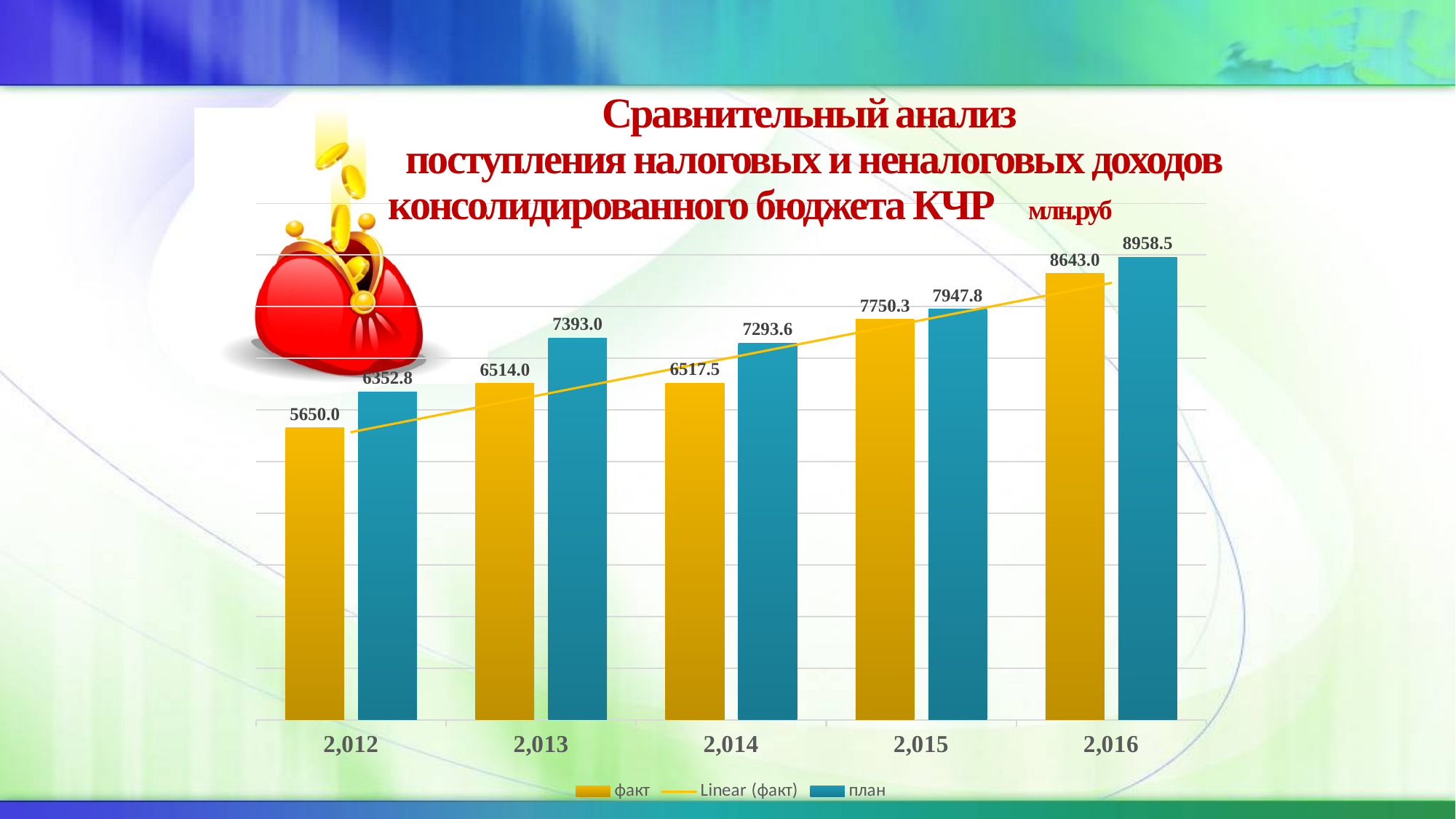
What kind of chart is shown on the slide? bar chart What is the value of план for 2,016? 8958.5 How many years are shown on the x axis? 5 Which year has the lowest план value? 2,012 How many entries does the legend list? 3 What is the value of факт for 2,015? 7750.3 Which year has the highest факт value? 2,016 What is the difference between план and факт for 2,013? 879.0 What is the value of план for 2,014? 7293.6 What is the difference between факт for 2,016 and факт for 2,012? 2993.0 Which is larger for 2,015: факт or план? план What is the value of факт for 2,012? 5650.0